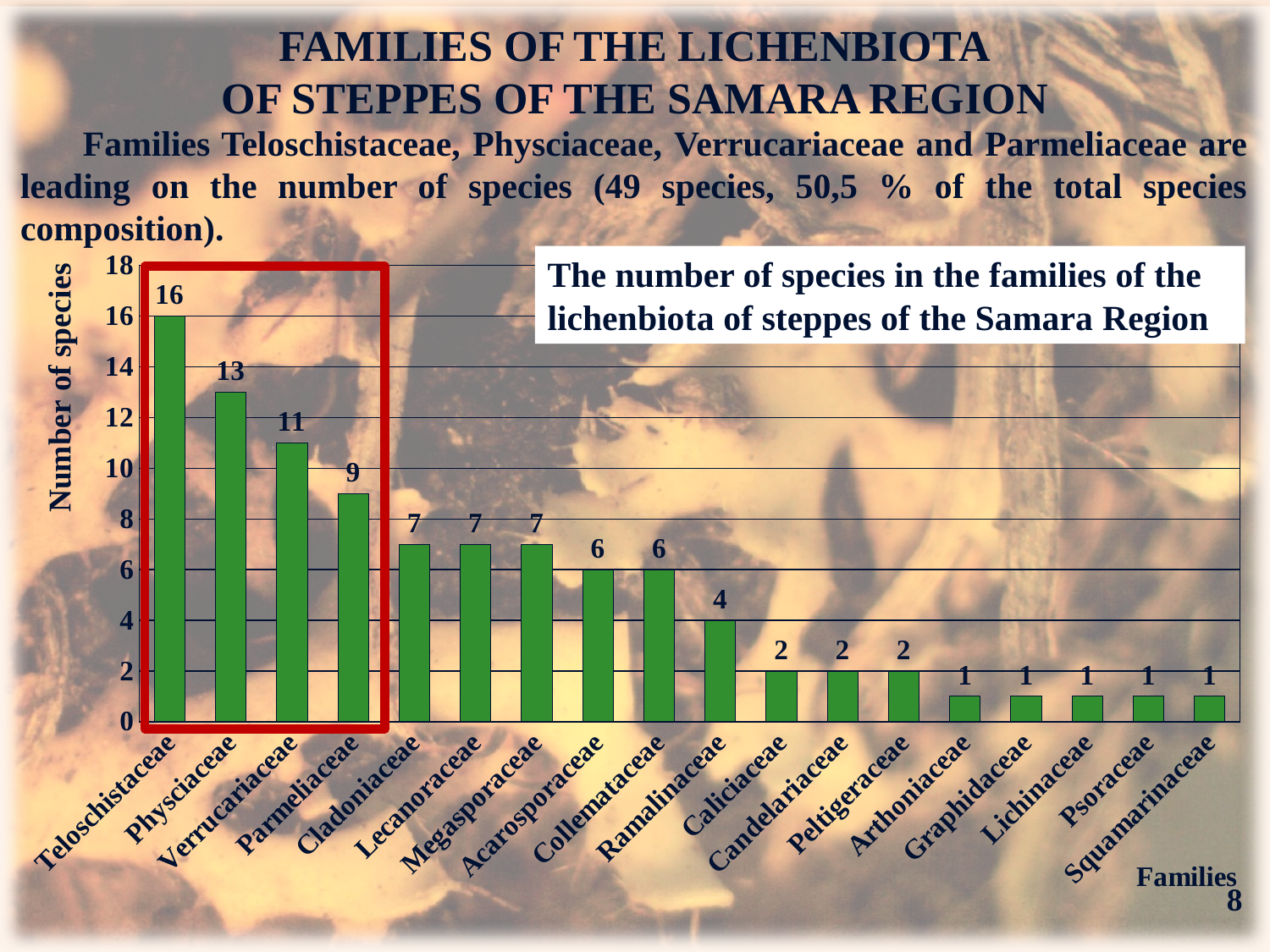
What is the label of the y axis of the chart? Number of species How many families have exactly 1 species? 5 What is the number of species for Teloschistaceae? 16 What is the difference in number of species between Teloschistaceae and Physciaceae? 3 Which has more species, Acarosporaceae or Ramalinaceae? Acarosporaceae What is the number of species for Parmeliaceae? 9 Do the values rise or fall moving from left to right along the x axis? Fall What is the difference in number of species between Verrucariaceae and Cladoniaceae? 4 What is the number of species for Ramalinaceae? 4 What type of chart is shown on the slide? Bar chart Which family has the highest number of species? Teloschistaceae How many families are shown on the x axis of the chart? 18